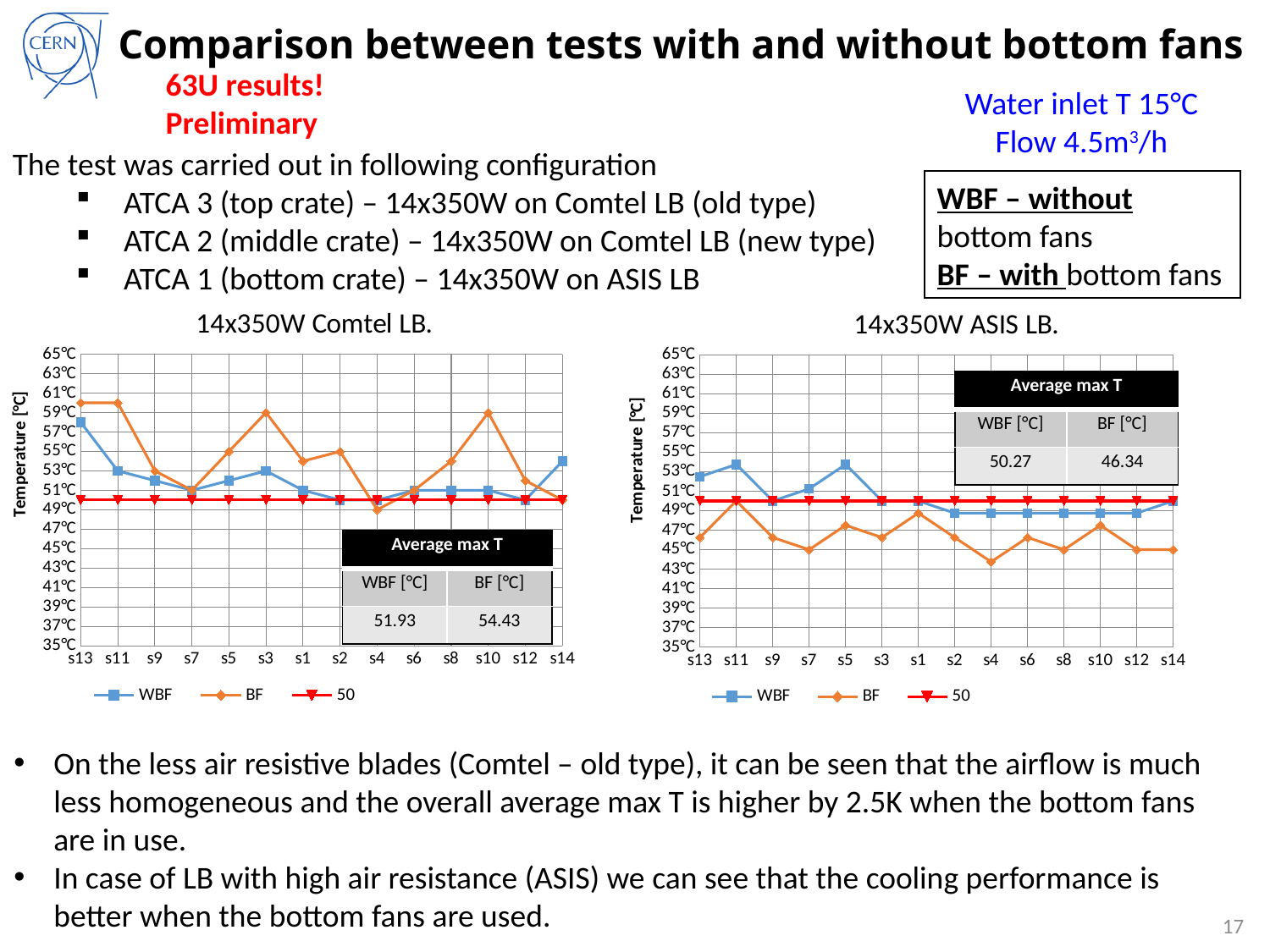
How many series does the legend of the 14x350W ASIS LB. chart list? 3 How many slot categories are shown on the x axis of the 14x350W Comtel LB. chart? 14 In the 14x350W ASIS LB. chart, is the BF value at s4 greater or less than 45°C? less In the 14x350W Comtel LB. chart, is the BF value at s13 greater or less than 55°C? greater In the 14x350W Comtel LB. chart, what is the Average max T for BF [°C]? 54.43 What type of chart is the 14x350W Comtel LB. chart? line chart In the 14x350W ASIS LB. chart, what is the Average max T for WBF [°C]? 50.27 In the 14x350W Comtel LB. chart, what is the Average max T for WBF [°C]? 51.93 In the 14x350W ASIS LB. chart, which series has the higher value at s11, WBF or BF? WBF What are the names of the three series in the legend of the 14x350W Comtel LB. chart? WBF, BF, 50 In the 14x350W ASIS LB. chart, what is the Average max T for BF [°C]? 46.34 In the 14x350W ASIS LB. chart, what is the difference between the Average max T for WBF and for BF? 3.93